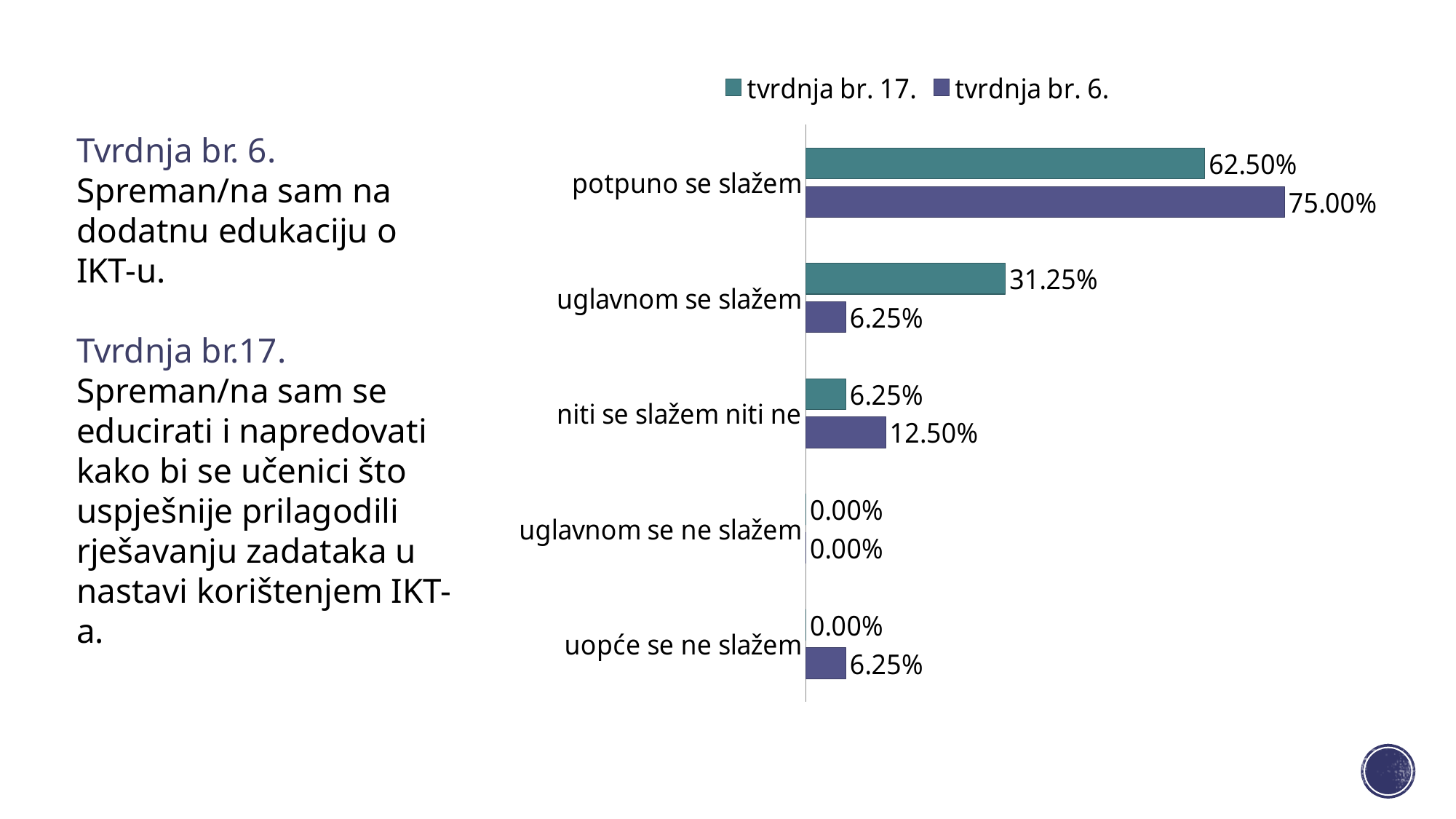
How many categories are shown on the chart? 5 Which series is shown in teal in the legend? tvrdnja br. 17. For "uglavnom se slažem", which series has the larger value, "tvrdnja br. 17." or "tvrdnja br. 6."? tvrdnja br. 17. What is the value for "uglavnom se slažem" in the "tvrdnja br. 17." series? 31.25% Which category has the highest value in the "tvrdnja br. 17." series? potpuno se slažem How many series does the legend list? 2 What kind of chart is shown on the slide? bar chart What is the difference between the "tvrdnja br. 6." and "tvrdnja br. 17." values for "potpuno se slažem"? 12.50% What is the value for "uopće se ne slažem" in the "tvrdnja br. 17." series? 0.00% What is the value for "niti se slažem niti ne" in the "tvrdnja br. 6." series? 12.50% What is the value for "potpuno se slažem" in the "tvrdnja br. 6." series? 75.00% Which category has the lowest value in the "tvrdnja br. 6." series? uglavnom se ne slažem